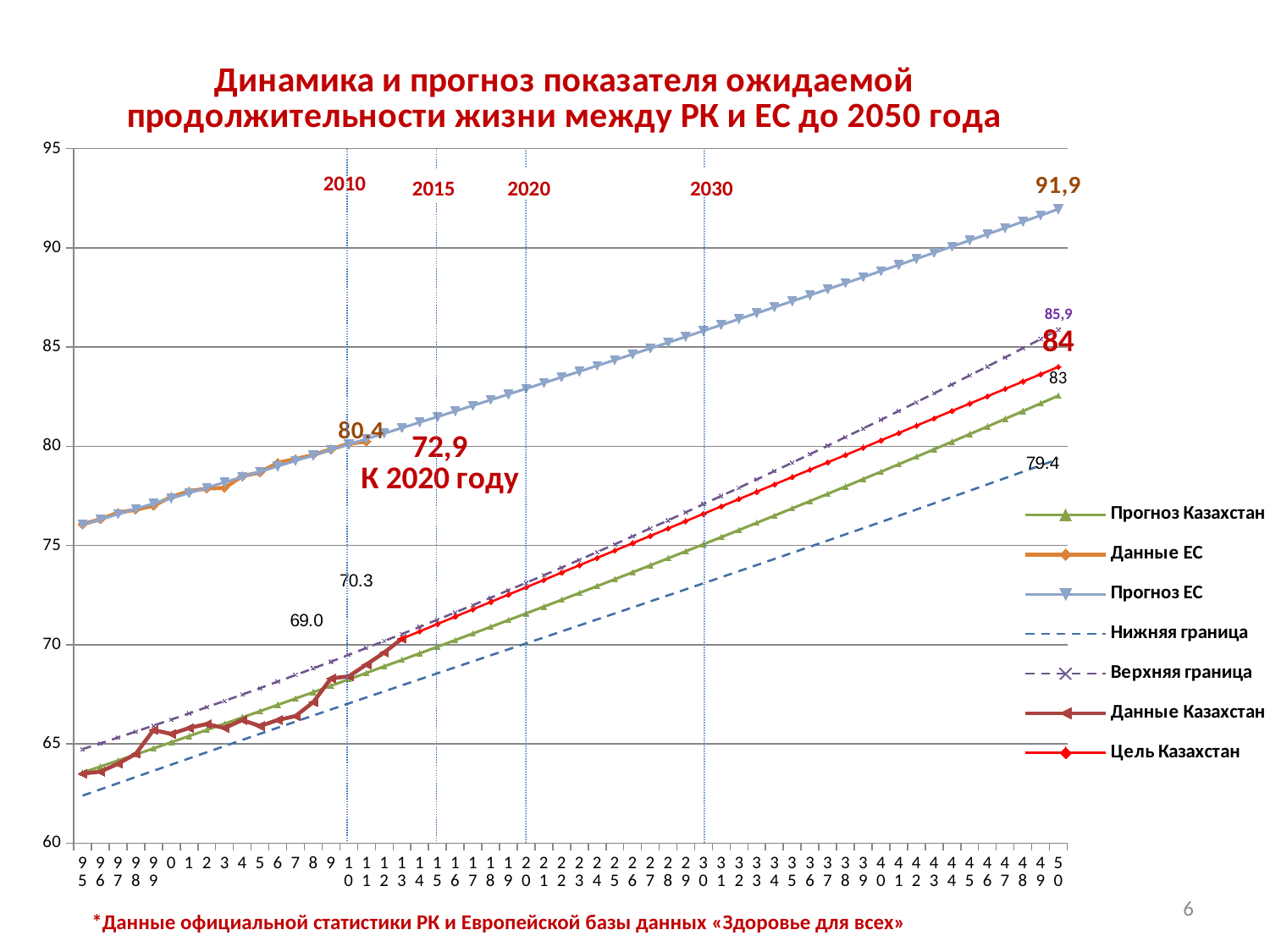
Is the Прогноз ЕС value in 2020 greater or less than 80? greater What value does the Прогноз ЕС series reach in 2050? 91,9 What value does the Нижняя граница series reach in 2050? 79.4 What kind of chart is shown on the slide? line chart What is the difference between the Прогноз ЕС value and the Цель Казахстан value in 2050? 7,9 Which series has the highest value in 2050? Прогноз ЕС What value does the Верхняя граница series reach in 2050? 85,9 What value does the Цель Казахстан series reach in 2050? 84 What target value is annotated for 2020 (к 2020 году)? 72,9 Does the Прогноз ЕС series rise or fall from 2010 to 2050? rises What value is labelled for Данные ЕС at 2010? 80.4 How many series does the legend list? 7